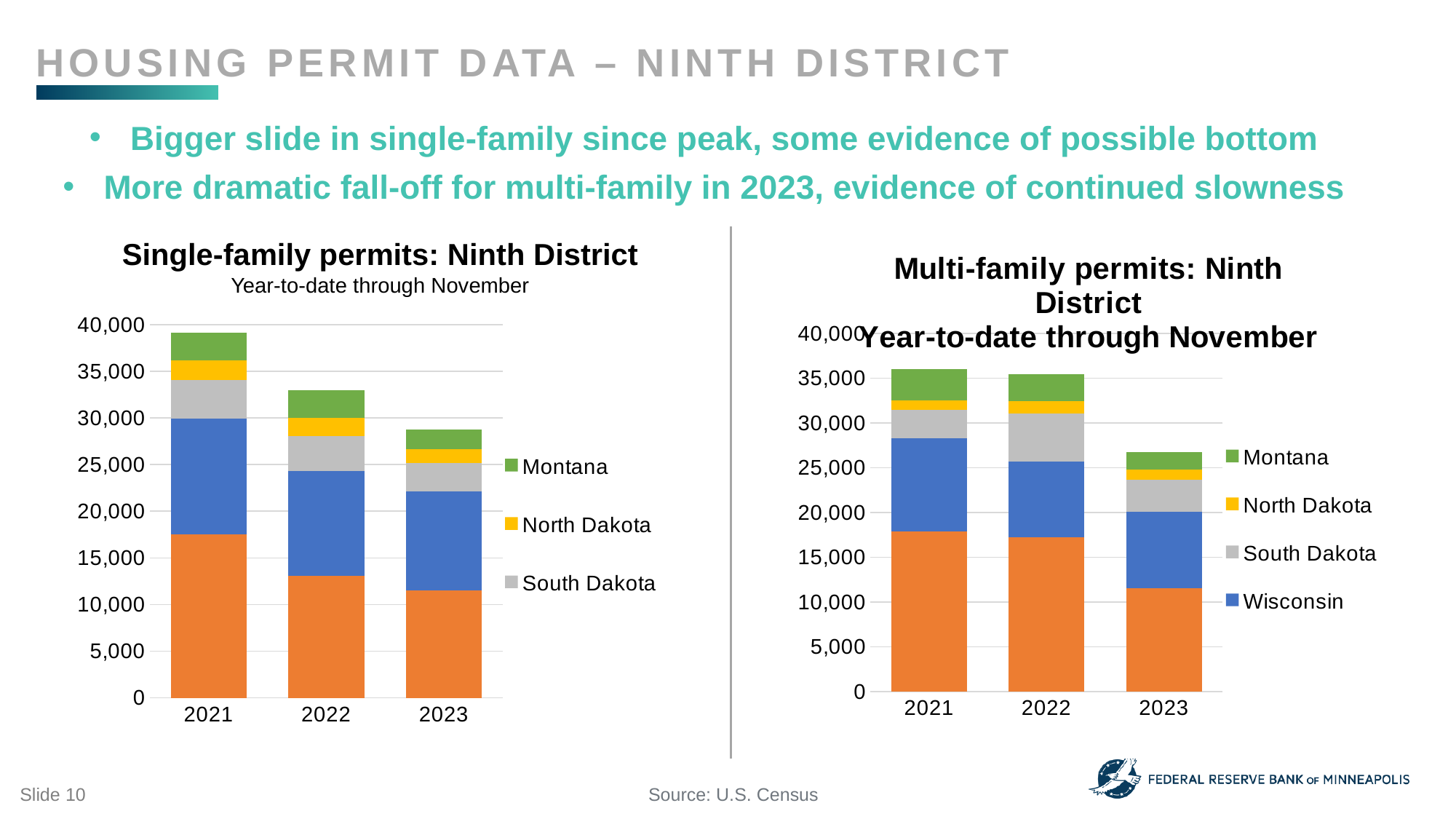
In the Single-family permits: Ninth District chart, is the total for 2023 greater or less than 30,000? less What kind of chart is the Single-family permits: Ninth District chart? stacked bar chart In the Single-family permits: Ninth District chart, is the total for 2021 greater or less than 35,000? greater In the Single-family permits: Ninth District chart, which year has the lowest total bar? 2023 In the Single-family permits: Ninth District chart, which year has the highest total bar? 2021 In the Single-family permits: Ninth District chart, do the total bars rise or fall from 2021 to 2023? fall How many series does the legend of the Multi-family permits: Ninth District chart list? 4 In the Multi-family permits: Ninth District chart, is the total for 2023 greater or less than 30,000? less What colour represents Montana in the Single-family permits: Ninth District chart? green How many years are shown on the x axis of the Multi-family permits: Ninth District chart? 3 In the Multi-family permits: Ninth District chart, which year has the lowest total bar? 2023 In the Multi-family permits: Ninth District chart, which total bar is larger, 2022 or 2023? 2022